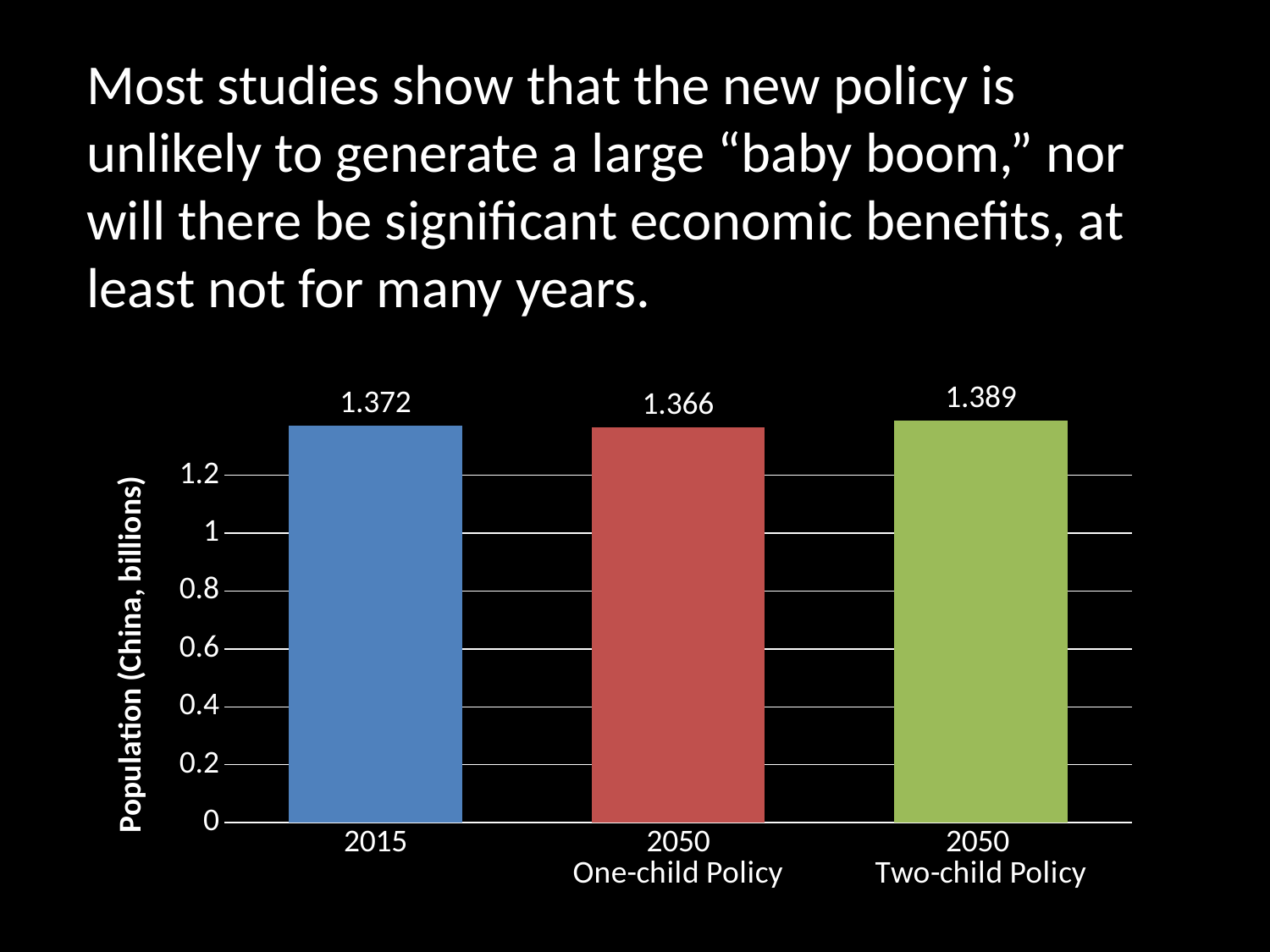
What is the difference between the values for 2015 and 2050 One-child Policy? 0.006 What is the value for 2050 One-child Policy? 1.366 What is the difference between the values for 2050 Two-child Policy and 2050 One-child Policy? 0.023 Which category has the highest value? 2050 Two-child Policy How many bars are shown in the chart? 3 Is the value for 2050 One-child Policy greater or less than 1.2? greater What is the label of the vertical axis? Population (China, billions) Which category has the lowest value? 2050 One-child Policy What is the value for 2015? 1.372 What kind of chart is shown on the slide? bar chart Which is larger, the value for 2015 or the value for 2050 Two-child Policy? 2050 Two-child Policy What is the value for 2050 Two-child Policy? 1.389